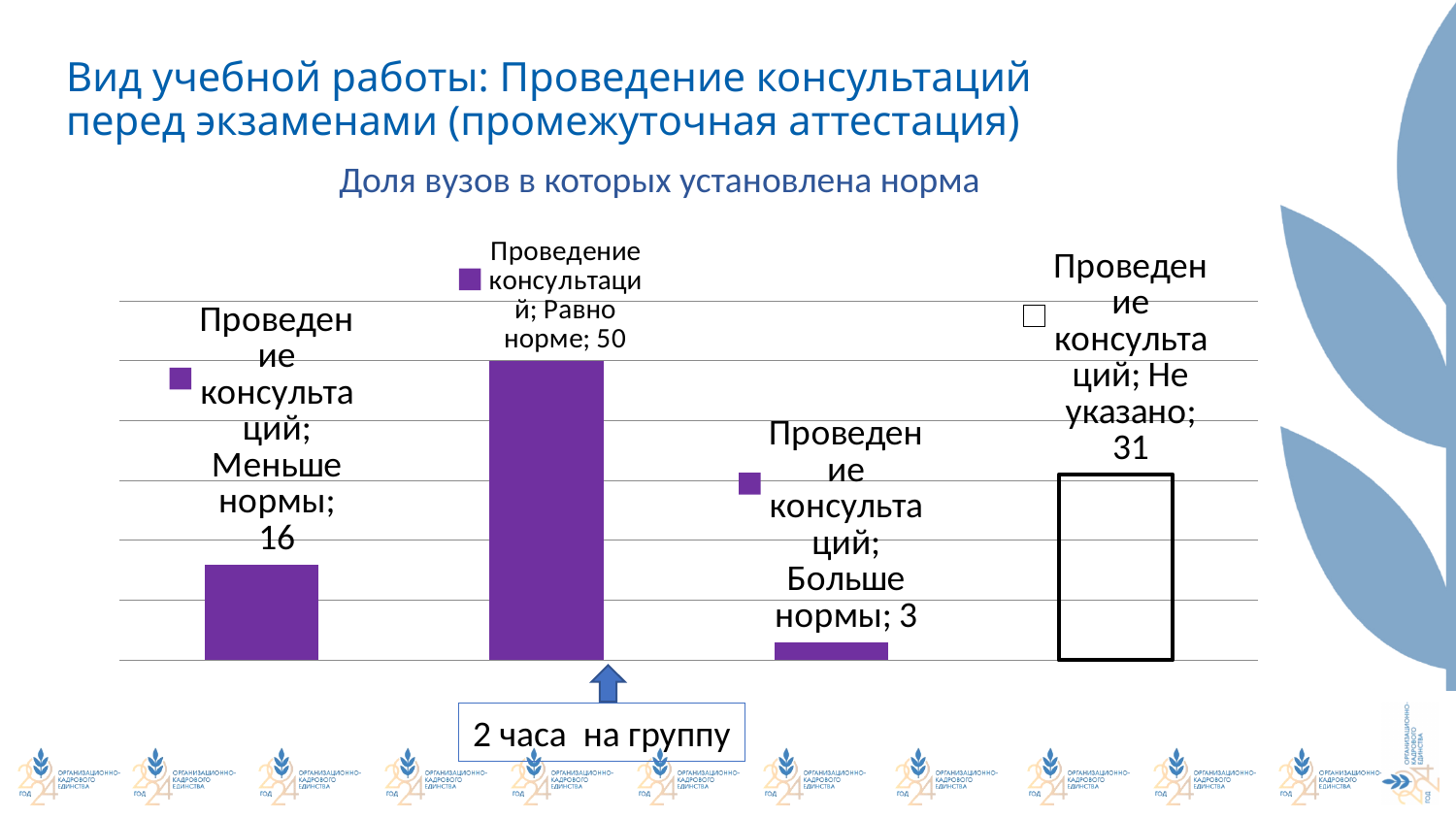
What is the difference between the values for "Равно норме" and "Не указано"? 19 What value is shown for the category "Меньше нормы"? 16 What kind of chart is shown on the slide? Bar chart Which is larger: the value for "Не указано" or the value for "Меньше нормы"? Не указано Which category has the highest value? Равно норме What is the title of the chart? Доля вузов в которых установлена норма What value is shown for the category "Больше нормы"? 3 What is the difference between the values for "Меньше нормы" and "Больше нормы"? 13 What value is shown for the category "Не указано"? 31 What value is shown for the category "Равно норме"? 50 Which category has the lowest value? Больше нормы How many categories (bars) are plotted in the chart? 4